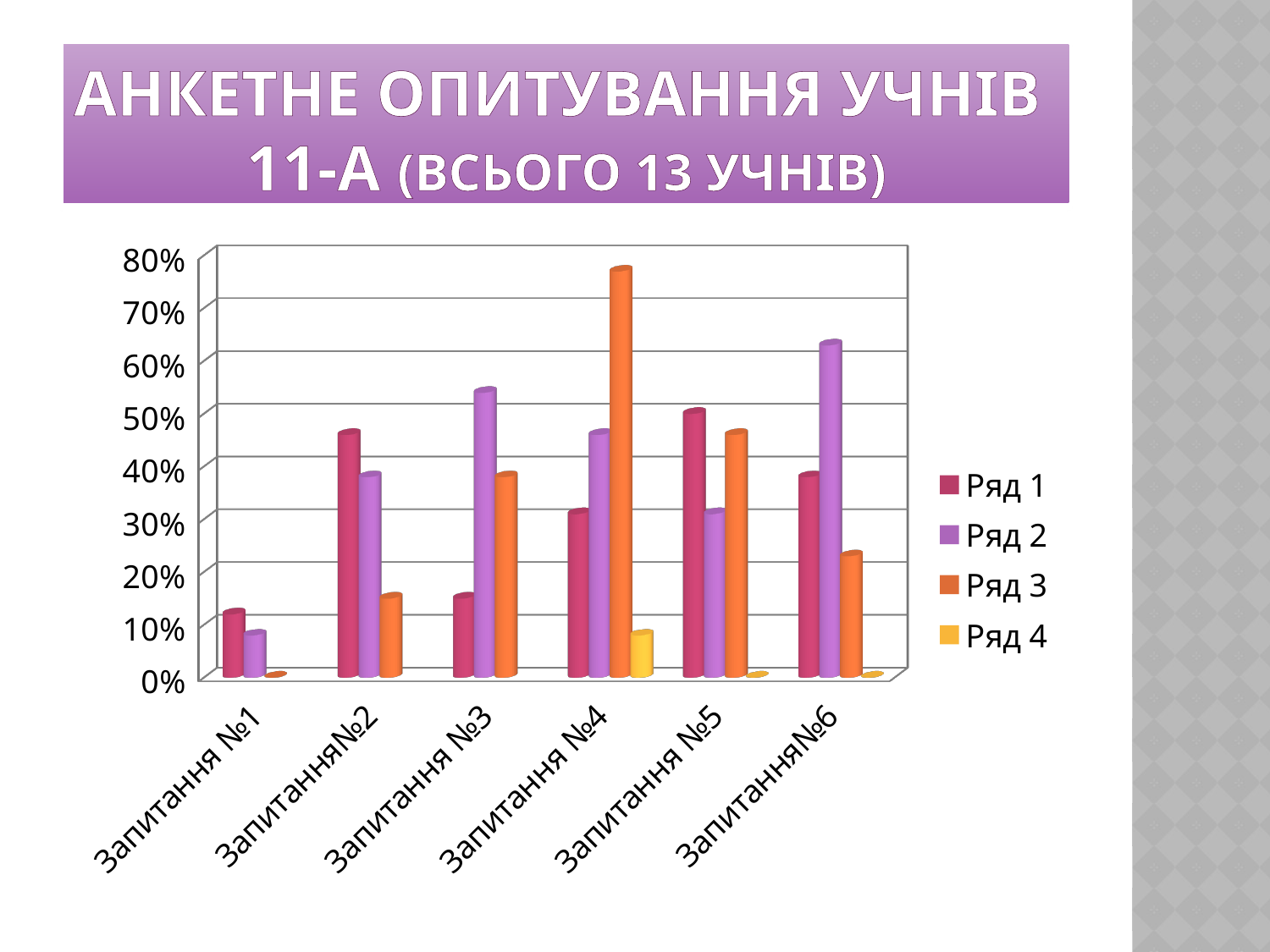
Is the value of Ряд 2 for Запитання №3 greater or less than 50%? greater For which category is the value of Ряд 2 the highest? Запитання№6 How many series does the legend list? 4 What is the name of the series shown in yellow in the legend? Ряд 4 For which category is the value of Ряд 3 the highest? Запитання №4 Which series has the highest value for Запитання №6? Ряд 2 Is the value of Ряд 3 for Запитання №4 greater or less than 70%? greater Is the value of Ряд 1 for Запитання №1 greater or less than 20%? less How many categories (questions) are shown on the x axis? 6 For Запитання №2, which is larger: Ряд 1 or Ряд 2? Ряд 1 What kind of chart is shown on the slide? bar chart